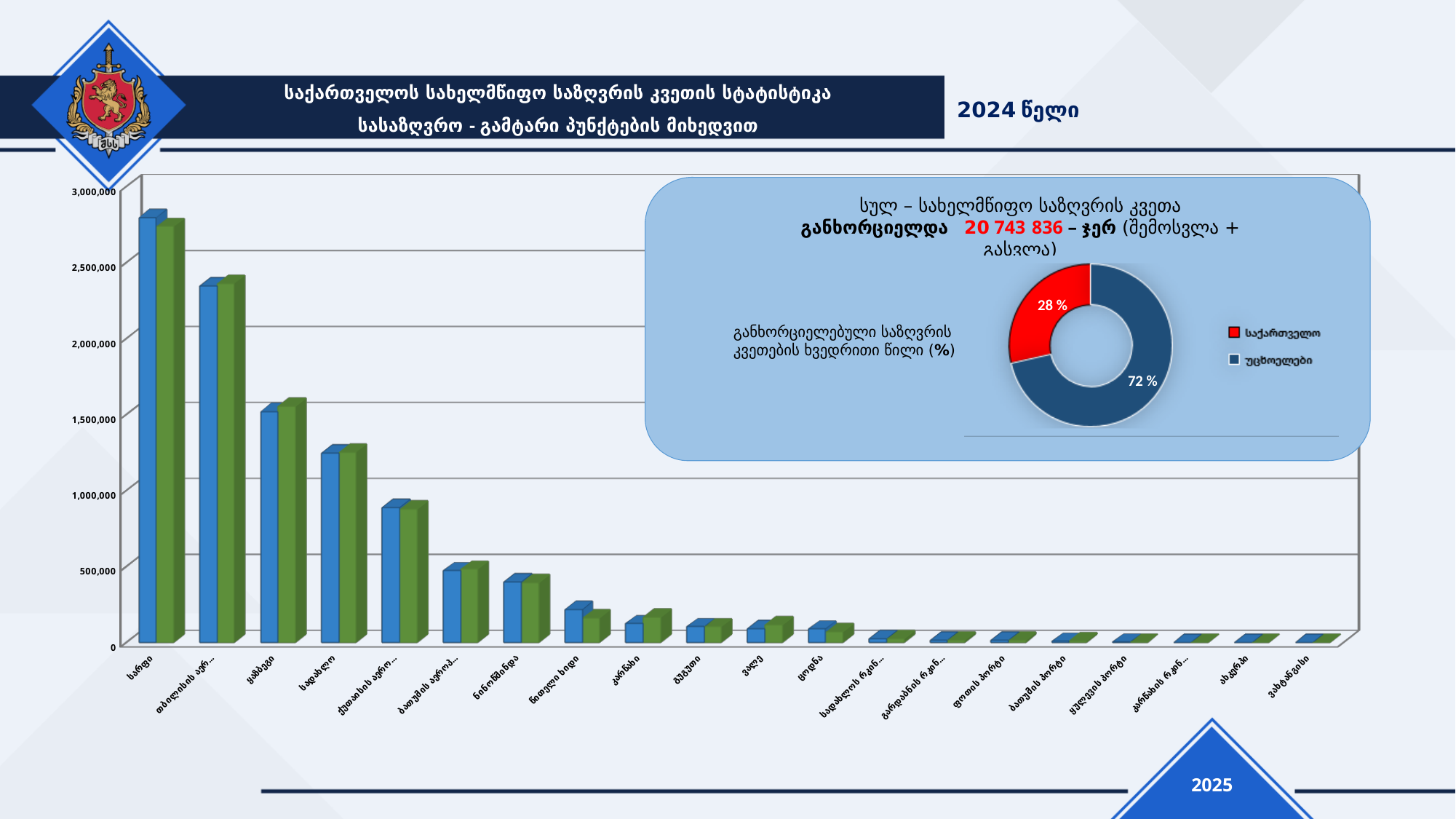
In the donut chart on the right, what share is shown for საქართველო? 28 % How many entries does the legend of the donut chart on the right list? 2 In the bar chart on the left, is the blue bar for თბილისის აერ... greater or less than 2,000,000? greater In the bar chart on the left, do the values generally rise or fall from left to right along the x axis? fall In the bar chart on the left, which is larger: the value for სარფი or the value for ყაზბეგი? სარფი In the bar chart on the left, is the blue bar for სადახლო greater or less than 1,000,000? greater In the bar chart on the left, is the blue bar for სარფი greater or less than 2,500,000? greater What kind of chart is the large chart on the left of the slide? bar chart In the donut chart on the right, what share is shown for უცხოელები? 72 % How many categories are shown on the x axis of the bar chart on the left? 20 In the bar chart on the left, which category has the highest bars? სარფი